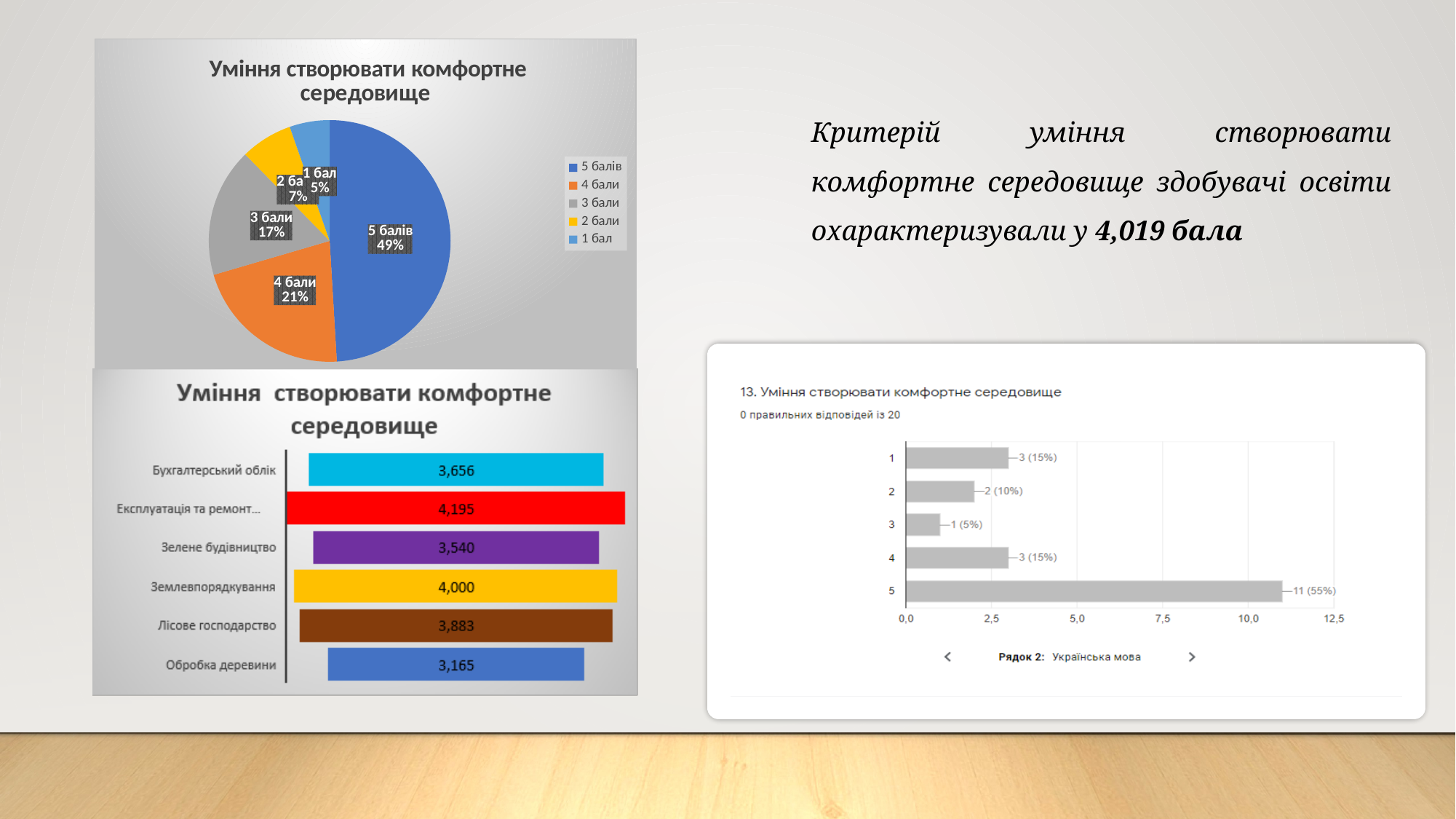
What kind of chart is shown at the bottom right of the slide? bar chart In the bar chart at the bottom left, how many categories are shown? 6 In the chart at the bottom right titled '13. Уміння створювати комфортне середовище', what is the label on the bar for category 5? 11 (55%) In the pie chart at the top left, what percentage is shown for '3 бали'? 17% In the bar chart at the bottom left, which category has the lowest value? Обробка деревини In the bar chart at the bottom left, which category has the highest value? Експлуатація та ремонт... In the chart at the bottom right, which category has the shortest bar? 3 In the bar chart at the bottom left, what is the difference between the values for 'Лісове господарство' and 'Зелене будівництво'? 0,343 In the pie chart at the top left, what share of the pie is labelled '5 балів'? 49% In the bar chart at the bottom left, what is the value for 'Землевпорядкування'? 4,000 In the pie chart at the top left, how many entries does the legend list? 5 In the pie chart at the top left, which category has the smallest slice? 1 бал